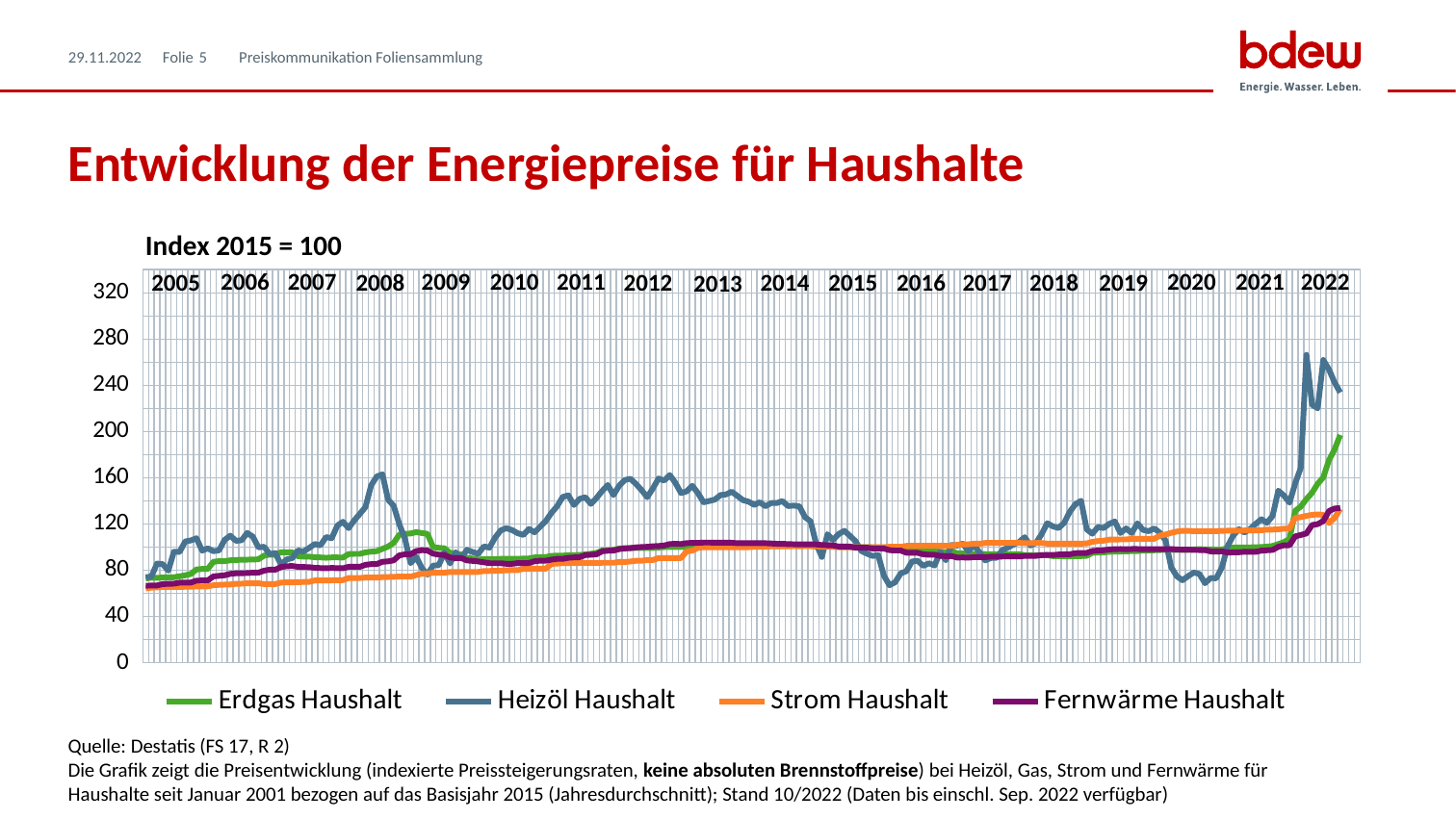
How many year labels are shown along the x axis? 18 How many series does the legend list? 4 Which series reaches the highest value anywhere on the chart? Heizöl Haushalt What kind of chart is shown on the slide? line chart Does the Erdgas Haushalt line rise or fall from 2021 to 2022? rise Which series is the lowest during 2020? Heizöl Haushalt At the end of the series in 2022, which is higher, Erdgas Haushalt or Strom Haushalt? Erdgas Haushalt Is the value of Erdgas Haushalt at the end of the series in 2022 greater or less than 160? greater Is the value of Strom Haushalt at the start of 2005 greater or less than 80? less What base year and index value does the chart use, as stated above the plot? Index 2015 = 100 Is the 2022 peak of Heizöl Haushalt greater or less than 240? greater Which series are listed in the legend? Erdgas Haushalt, Heizöl Haushalt, Strom Haushalt, Fernwärme Haushalt